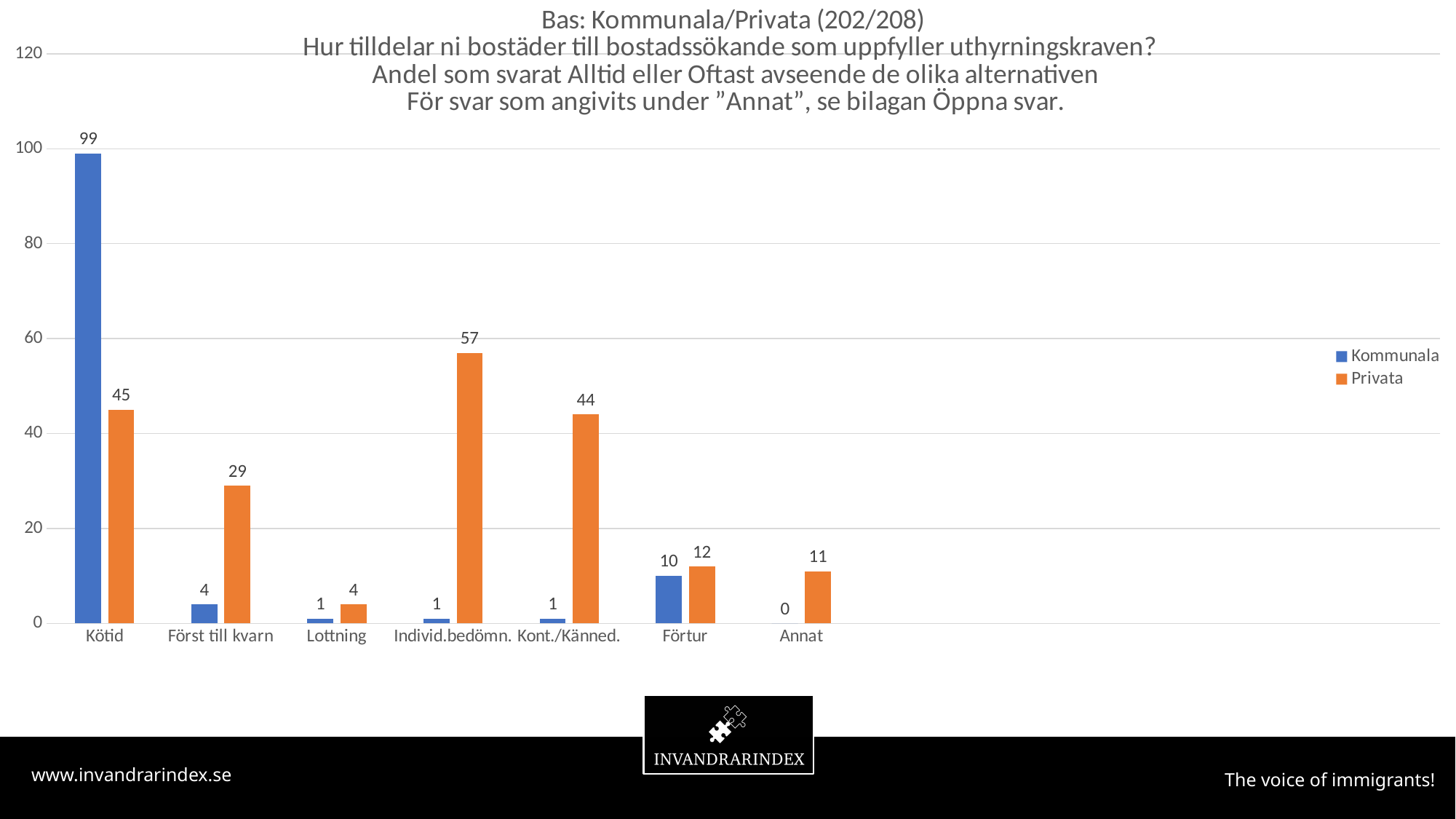
What is the difference between the Kommunala and Privata values for Kötid? 54 What is the Kommunala value for Annat? 0 What kind of chart is shown on the slide? Bar chart What is the Privata value for Individ.bedömn.? 57 Which category has the highest Privata value? Individ.bedömn. Which is larger for Förtur, the Kommunala value or the Privata value? Privata How many series does the legend list? 2 Which colour represents the Privata series? Orange How many categories are shown on the x axis? 7 What is the Privata value for Först till kvarn? 29 What is the Kommunala value for Kötid? 99 Which category has the lowest Kommunala value? Annat